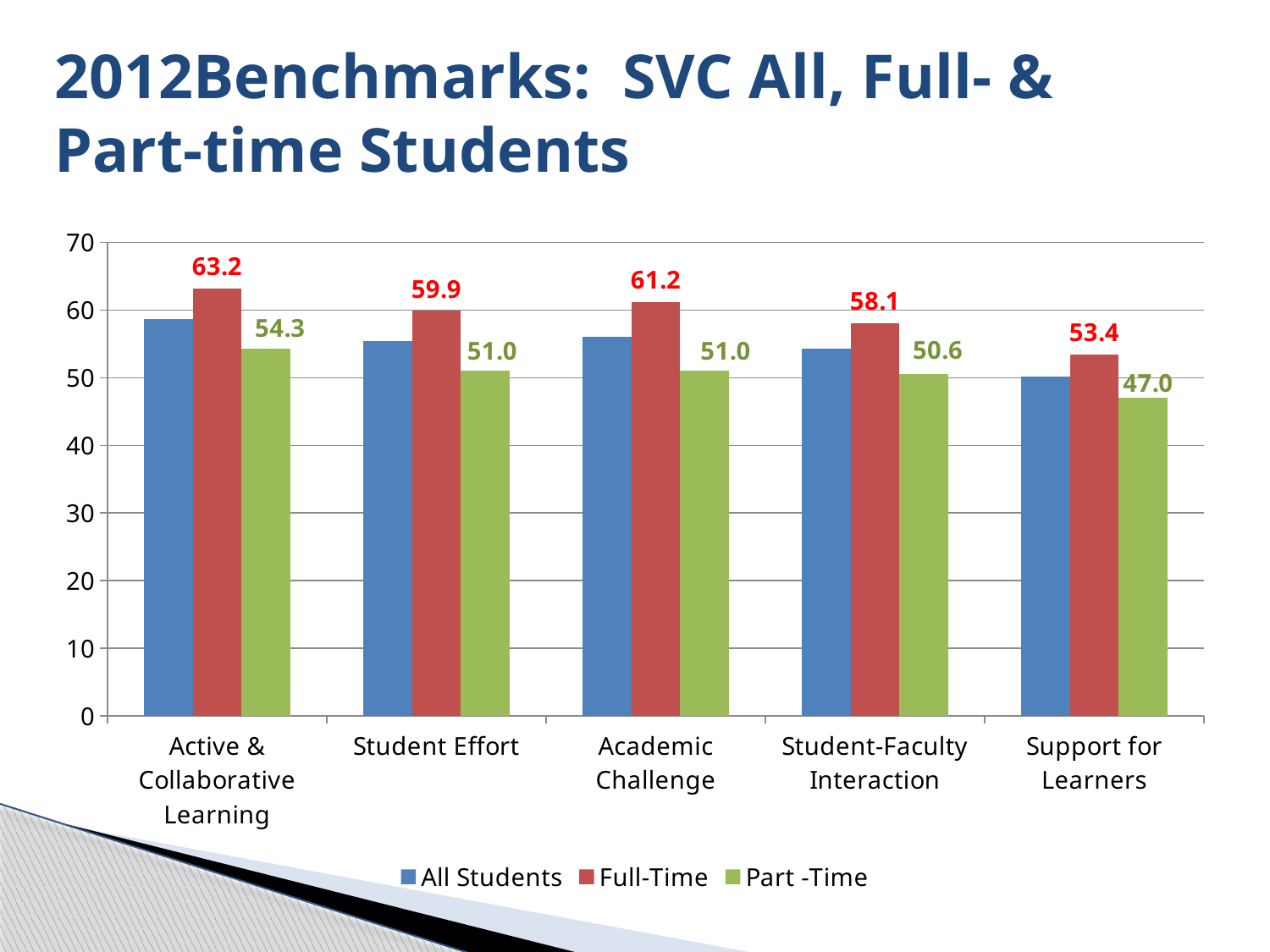
Which category has the highest Full-Time value? Active & Collaborative Learning Which is larger, the Full-Time value for Student Effort or the Full-Time value for Academic Challenge? Academic Challenge What is the Full-Time value for Active & Collaborative Learning? 63.2 How many series does the legend list? 3 What is the Full-Time value for Student-Faculty Interaction? 58.1 Which category has the lowest Part-Time value? Support for Learners What is the difference between the Full-Time and Part-Time values for Academic Challenge? 10.2 What kind of chart is shown on the slide? bar chart What is the Part-Time value for Support for Learners? 47.0 Which colour represents the Part-Time series? green Is the All Students value for Support for Learners greater or less than 60? less How many categories are shown on the x axis? 5